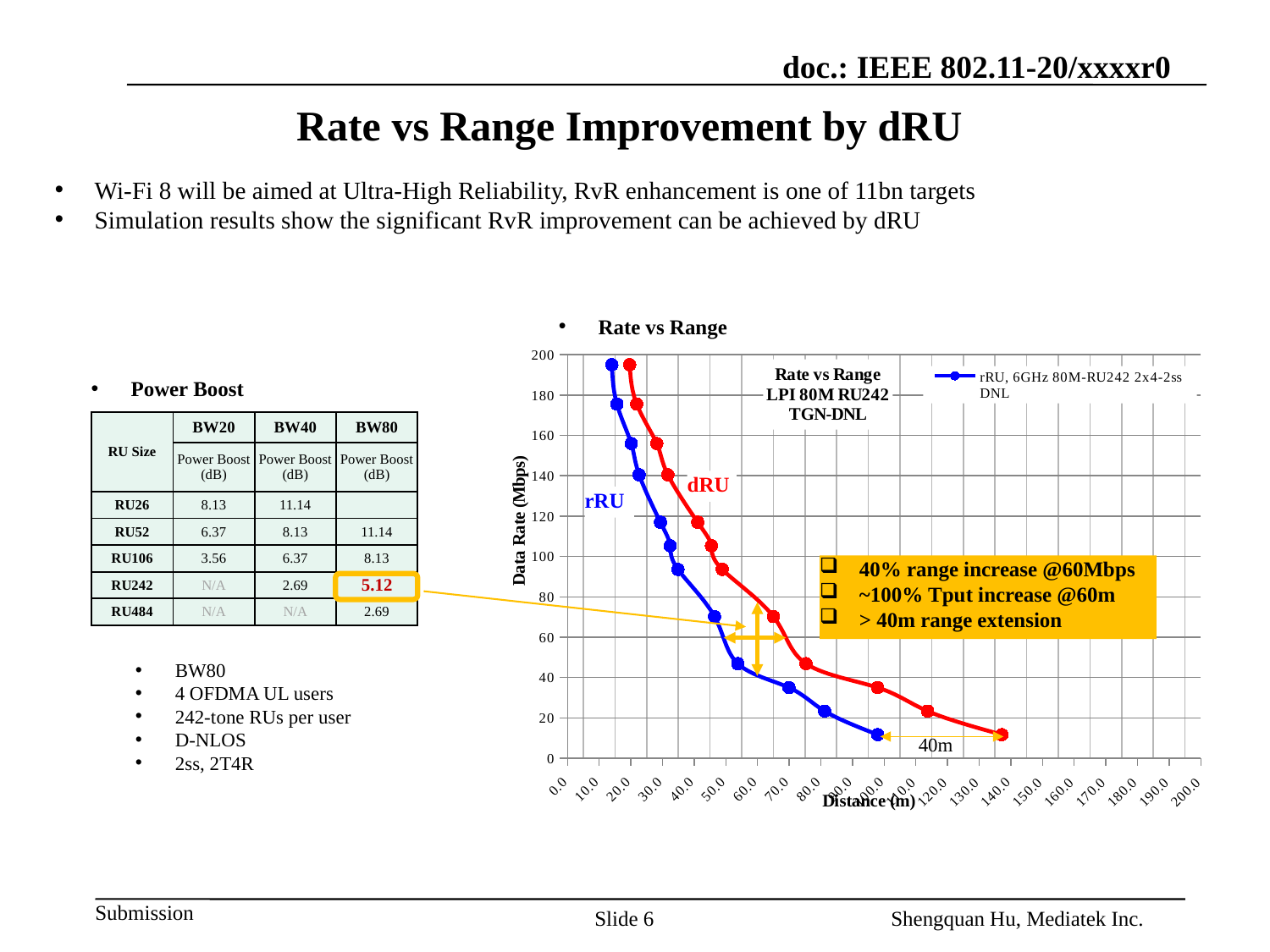
As distance increases along the x axis, does the data rate rise or fall? fall Which series reaches the greater maximum distance, rRU or dRU? dRU Which series has the lower data rate at a distance of about 80 m, rRU or dRU? rRU Is the farthest distance reached by the dRU series greater or less than 120 m? greater Is the data rate of the dRU series at about 100 m greater or less than 60 Mbps? less What kind of chart is shown on the slide? line chart At a data rate of 60 Mbps, which series is at the greater distance, rRU or dRU? dRU What is the label of the vertical axis of the chart? Data Rate (Mbps) Is the farthest distance reached by the rRU series greater or less than 110 m? less What is the title of the chart? Rate vs Range LPI 80M RU242 TGN-DNL